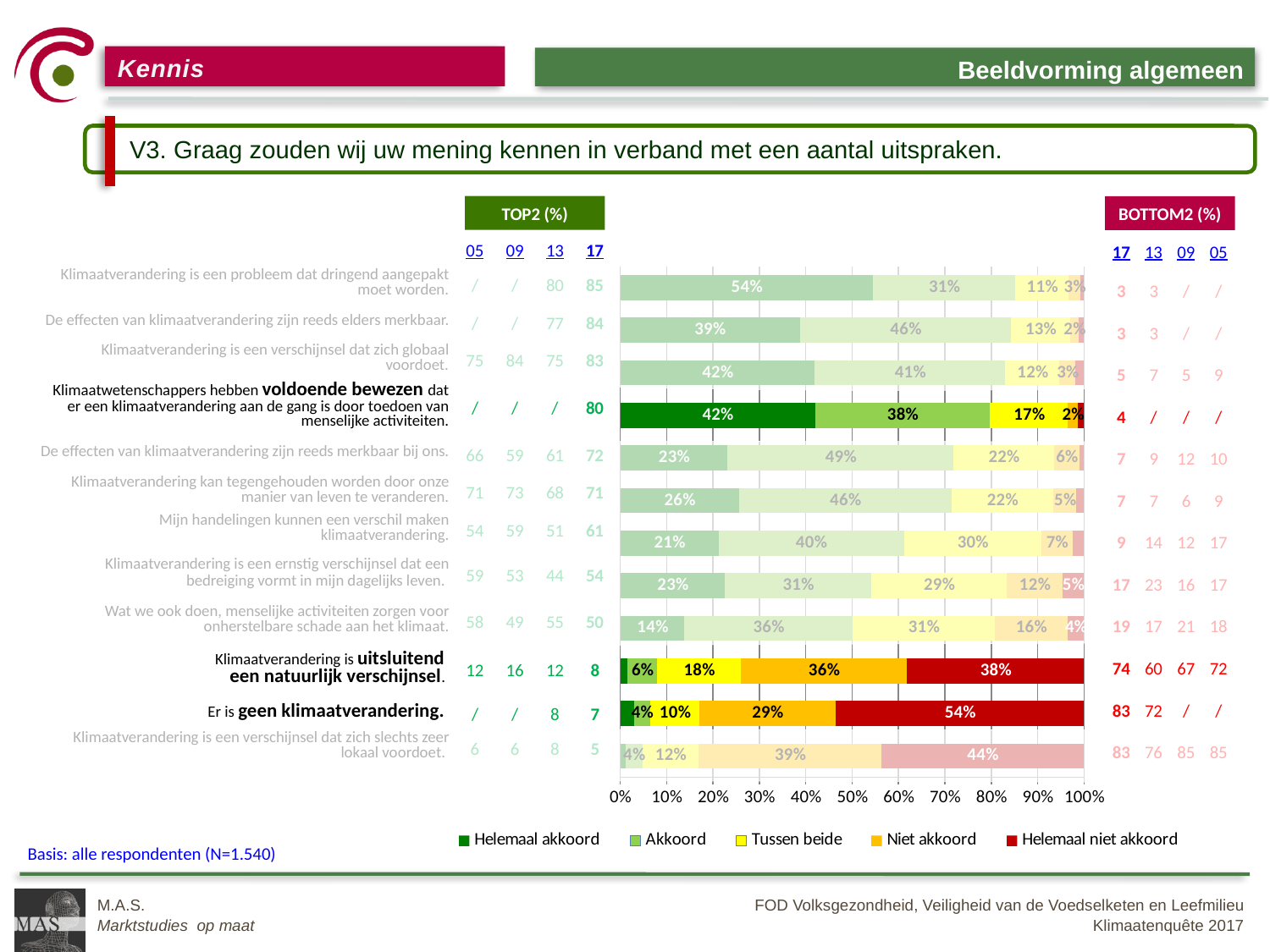
What is the 'Tussen beide' value for the statement 'Klimaatwetenschappers hebben voldoende bewezen dat er een klimaatverandering aan de gang is door toedoen van menselijke activiteiten'? 17% What kind of chart is shown on the slide? Stacked bar chart What is the 'Helemaal niet akkoord' value for the statement 'Er is geen klimaatverandering'? 54% Which statement has the highest 'Helemaal niet akkoord' value? Er is geen klimaatverandering. How many series does the chart legend list? 5 Which is larger: the 'Helemaal akkoord' value for 'De effecten van klimaatverandering zijn reeds elders merkbaar' or for 'Klimaatverandering is een verschijnsel dat zich globaal voordoet'? Klimaatverandering is een verschijnsel dat zich globaal voordoet (42%) Which legend entry is shown in red? Helemaal niet akkoord What is the difference between the 'Akkoord' value for 'De effecten van klimaatverandering zijn reeds merkbaar bij ons' (49%) and the 'Akkoord' value for 'Mijn handelingen kunnen een verschil maken klimaatverandering' (40%)? 9% What is the 'Niet akkoord' value for the statement 'Klimaatverandering is uitsluitend een natuurlijk verschijnsel'? 36% How many statements (bars) are plotted in the chart? 12 What is the 'Helemaal akkoord' value for the statement 'Klimaatverandering is een probleem dat dringend aangepakt moet worden'? 54% Which statement has the highest 'Helemaal akkoord' value? Klimaatverandering is een probleem dat dringend aangepakt moet worden.